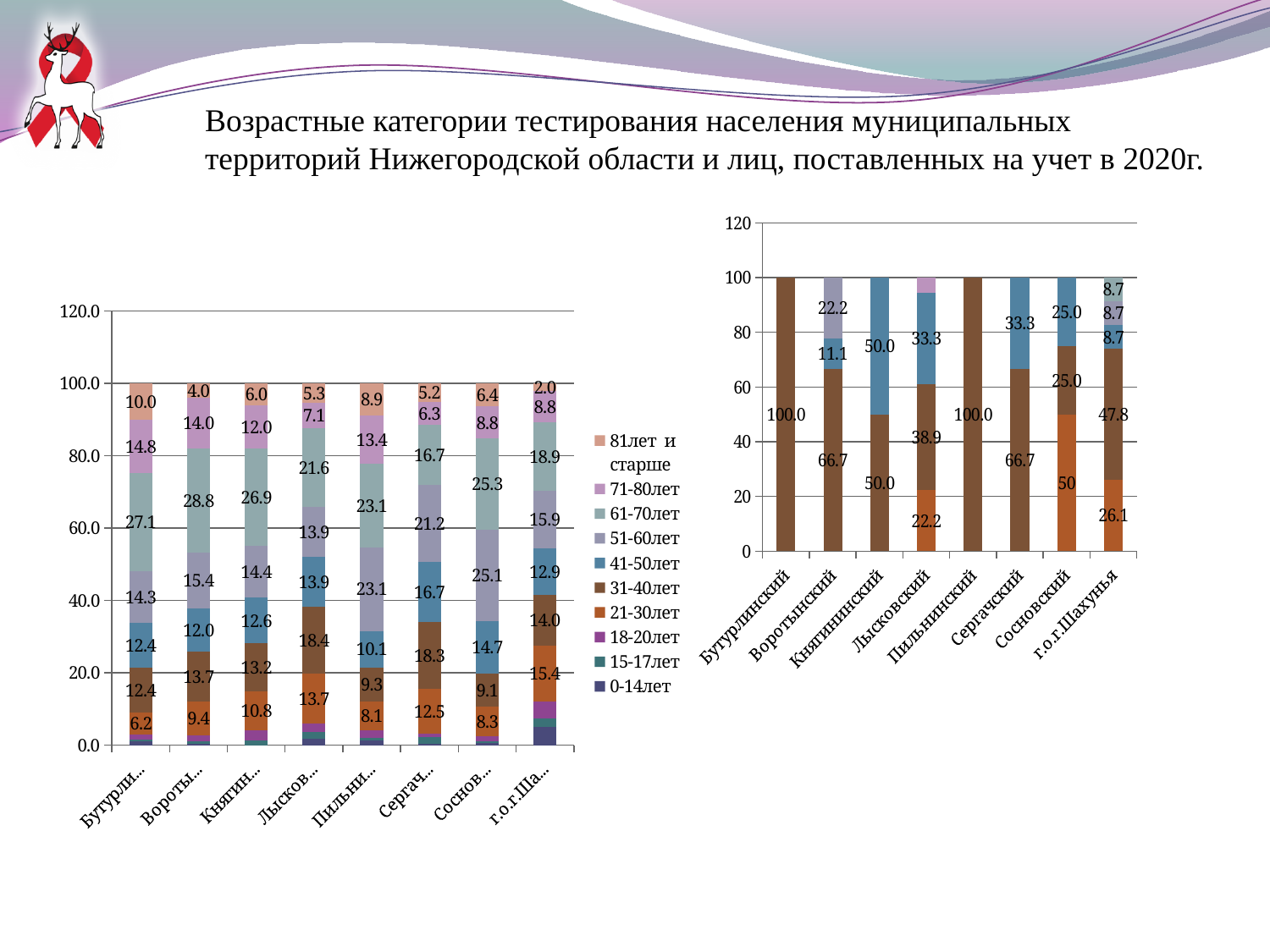
In the left chart, what is the 61-70лет value for the second bar (Вороты...)? 28.8 What kind of chart is the left chart? Stacked bar chart In the right chart, what is the value shown for Бутурлинский? 100.0 In the left chart, what is the 81лет и старше value for the last bar (г.о.г.Ша...)? 2.0 In the right chart, what is the value of the bottom orange segment for Лысковский? 22.2 How many series does the legend of the left chart list? 10 In the left chart, what is the 71-80лет value for the fifth bar (Пильни...)? 13.4 How many categories are shown on the x axis of the right chart? 8 In the right chart, what is the difference between the brown segment (66.7) and the blue segment (33.3) for Сергачский? 33.4 In the right chart, which category has the largest orange bottom segment? Сосновский In the left chart, which has the larger 61-70лет value: the second bar (Вороты...) or the fourth bar (Лысков...)? Вороты... In the right chart, what is the value of the brown segment for г.о.г.Шахунья? 47.8